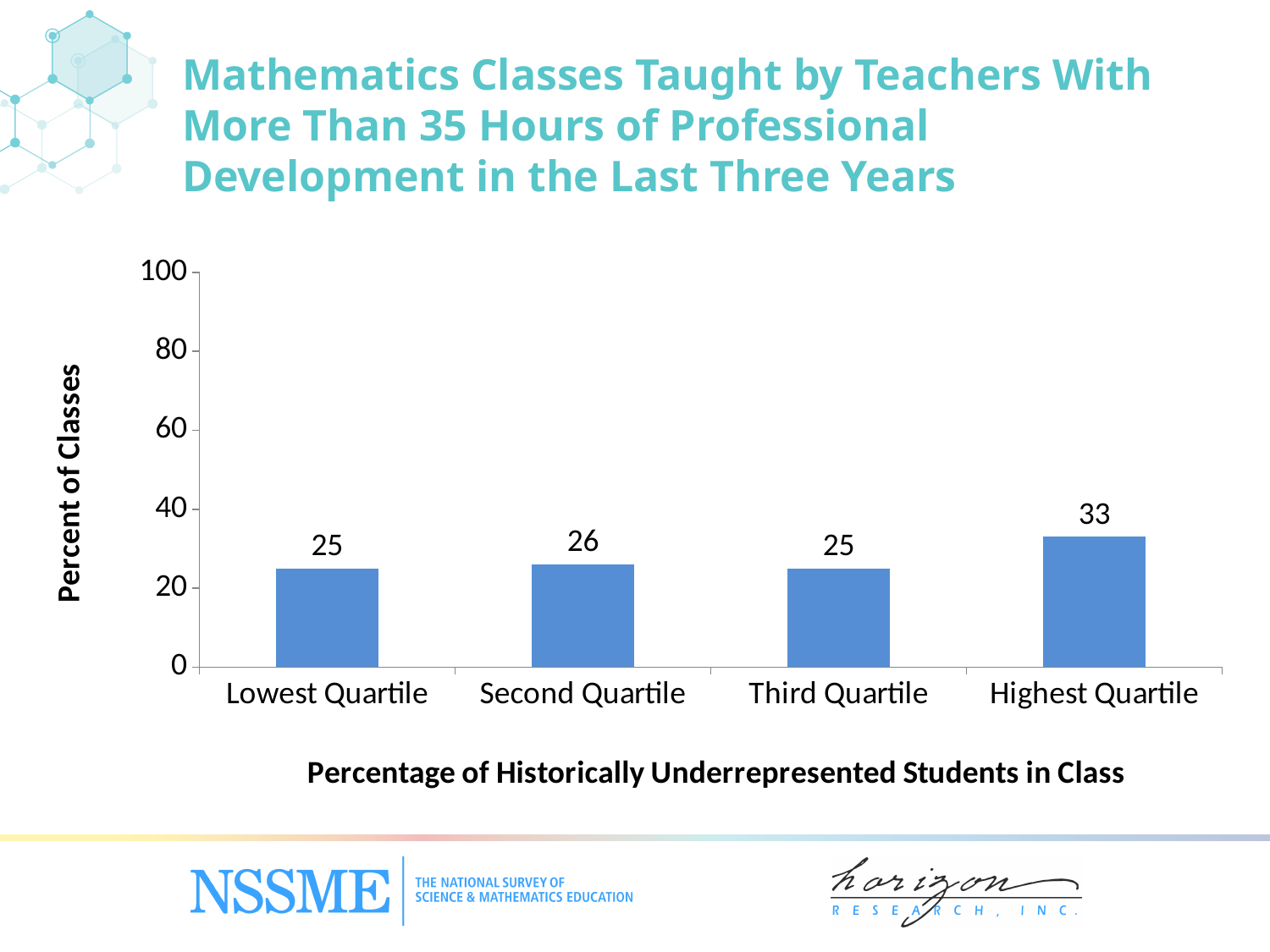
Which is larger, the value for Highest Quartile or the value for Second Quartile? Highest Quartile What is the label of the y axis? Percent of Classes What kind of chart is shown on the slide? bar chart What is the difference between the values for Highest Quartile and Third Quartile? 8 What is the difference between the values for Second Quartile and Lowest Quartile? 1 Is the value for Highest Quartile greater or less than 40? less Is the value for Third Quartile greater or less than 20? greater What is the value for Second Quartile? 26 What is the value for Lowest Quartile? 25 How many categories are shown on the x axis? 4 What is the value for Highest Quartile? 33 Which category has the highest value? Highest Quartile